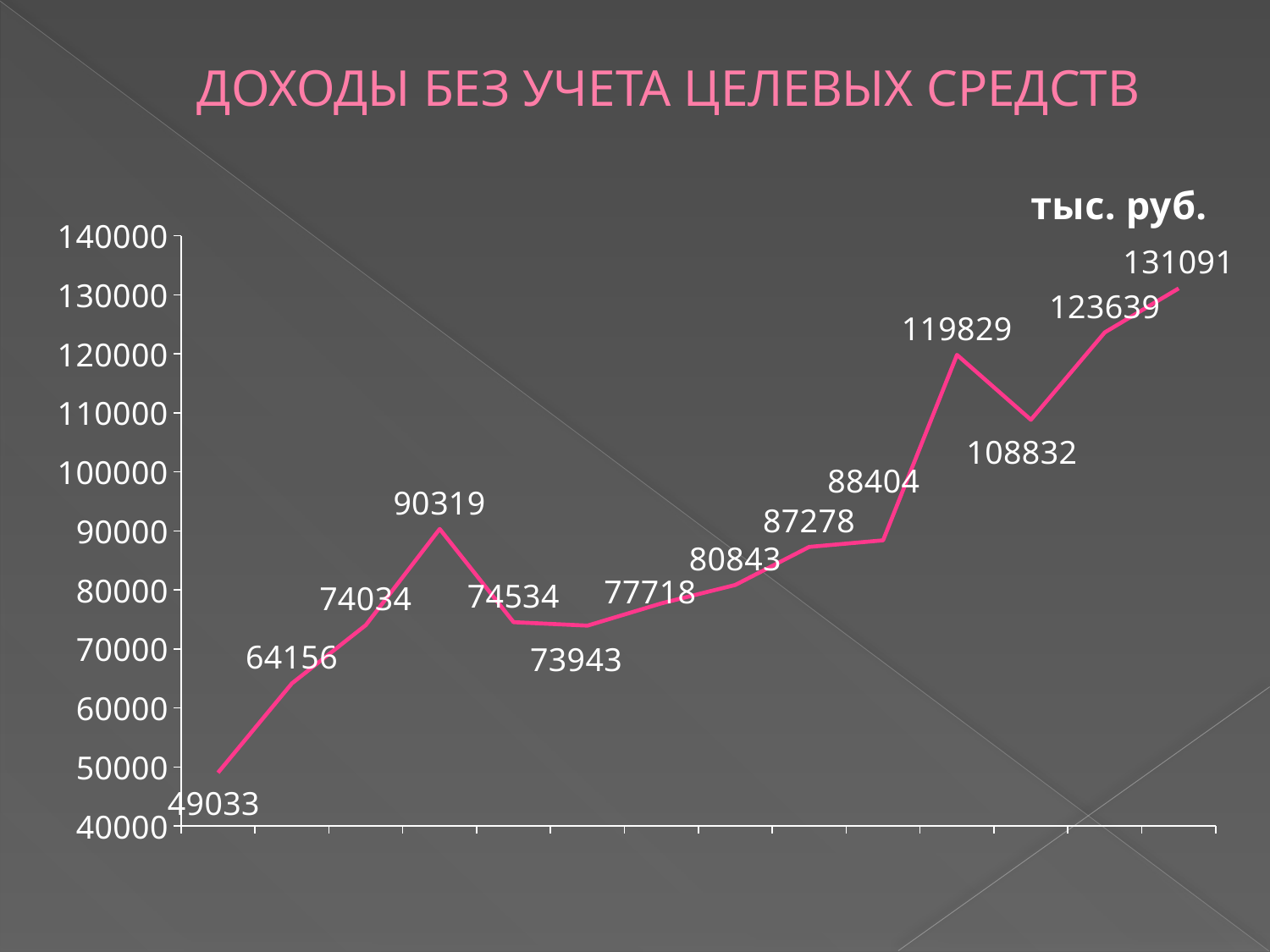
What is the lowest value plotted on the chart? 49033 What is the title of the chart? ДОХОДЫ БЕЗ УЧЕТА ЦЕЛЕВЫХ СРЕДСТВ What is the highest value plotted on the chart? 131091 Overall, do the values rise or fall from the first point to the last point along the x axis? rise What is the difference between the last data point (131091) and the first data point (49033)? 82058 What is the value of the last data point on the line? 131091 What kind of chart is shown on the slide? line chart What is the value of the first data point on the line? 49033 How many data points are plotted on the line? 14 What unit is indicated for the values in the chart? тыс. руб. Which is larger, the value 119829 or the value 108832 that follows it? 119829 What is the value of the fourth data point, at the first peak of the line? 90319